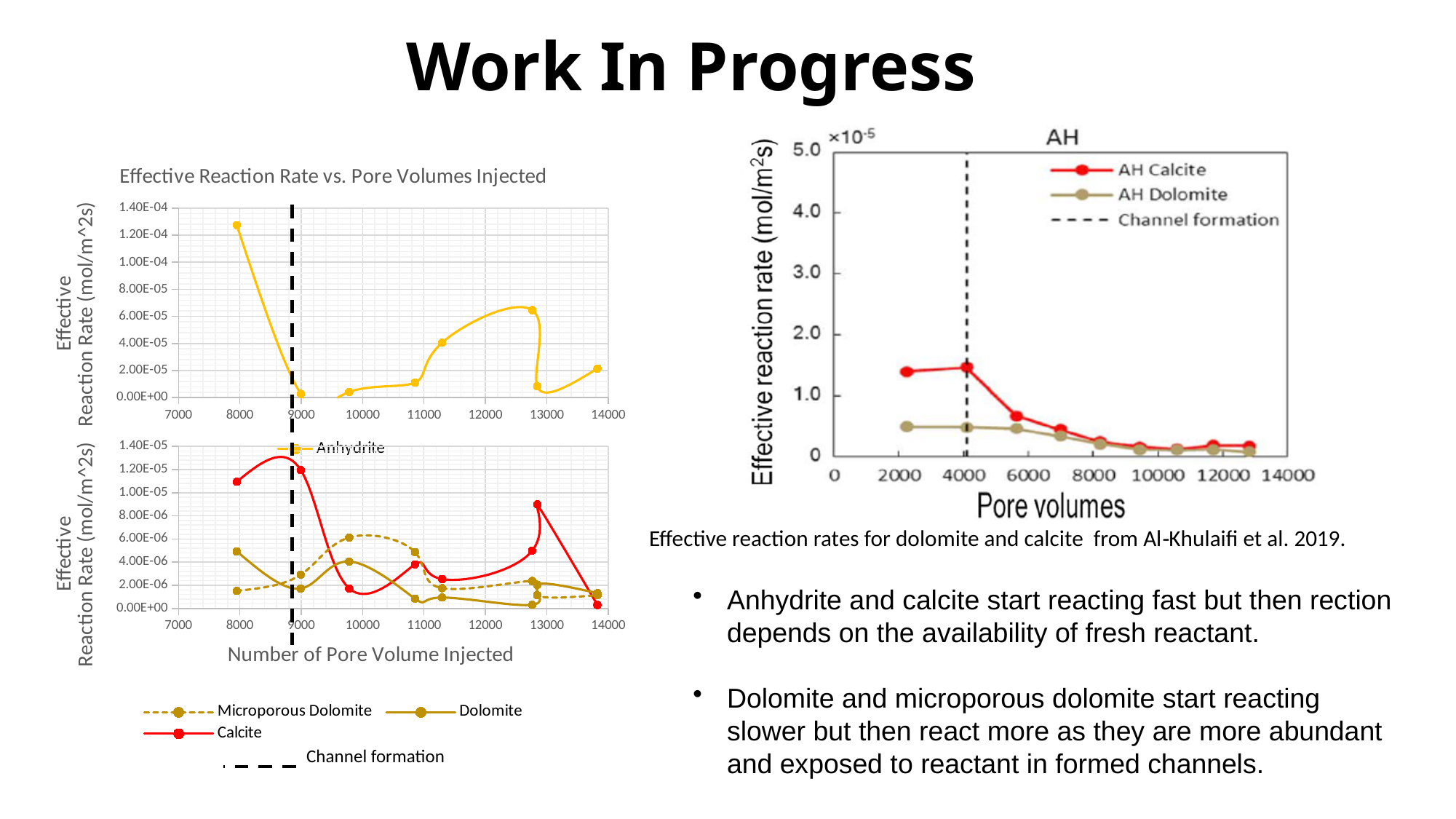
In the bottom-left chart, is the Calcite value at about 8000 pore volumes greater or less than 1.00E-05? greater In the right-hand 'AH' chart, at about 4000 pore volumes, which series has the larger value, AH Calcite or AH Dolomite? AH Calcite In the right-hand 'AH' chart, is the AH Calcite value at about 2000 pore volumes greater or less than 1.0 (×10^-5)? greater In the bottom-left chart, is the Dolomite value at about 8000 pore volumes greater or less than 2.00E-06? greater In the bottom-left chart, at about 10000 pore volumes, which series has the larger value, Microporous Dolomite or Calcite? Microporous Dolomite In the right-hand 'AH' chart, how many entries does the legend list? 3 What is the title of the top-left chart? Effective Reaction Rate vs. Pore Volumes Injected What is the title of the chart on the right side of the slide? AH What kind of chart is the top-left chart titled 'Effective Reaction Rate vs. Pore Volumes Injected'? line chart In the right-hand 'AH' chart, does the AH Calcite series rise or fall between 4000 and 10000 pore volumes? fall